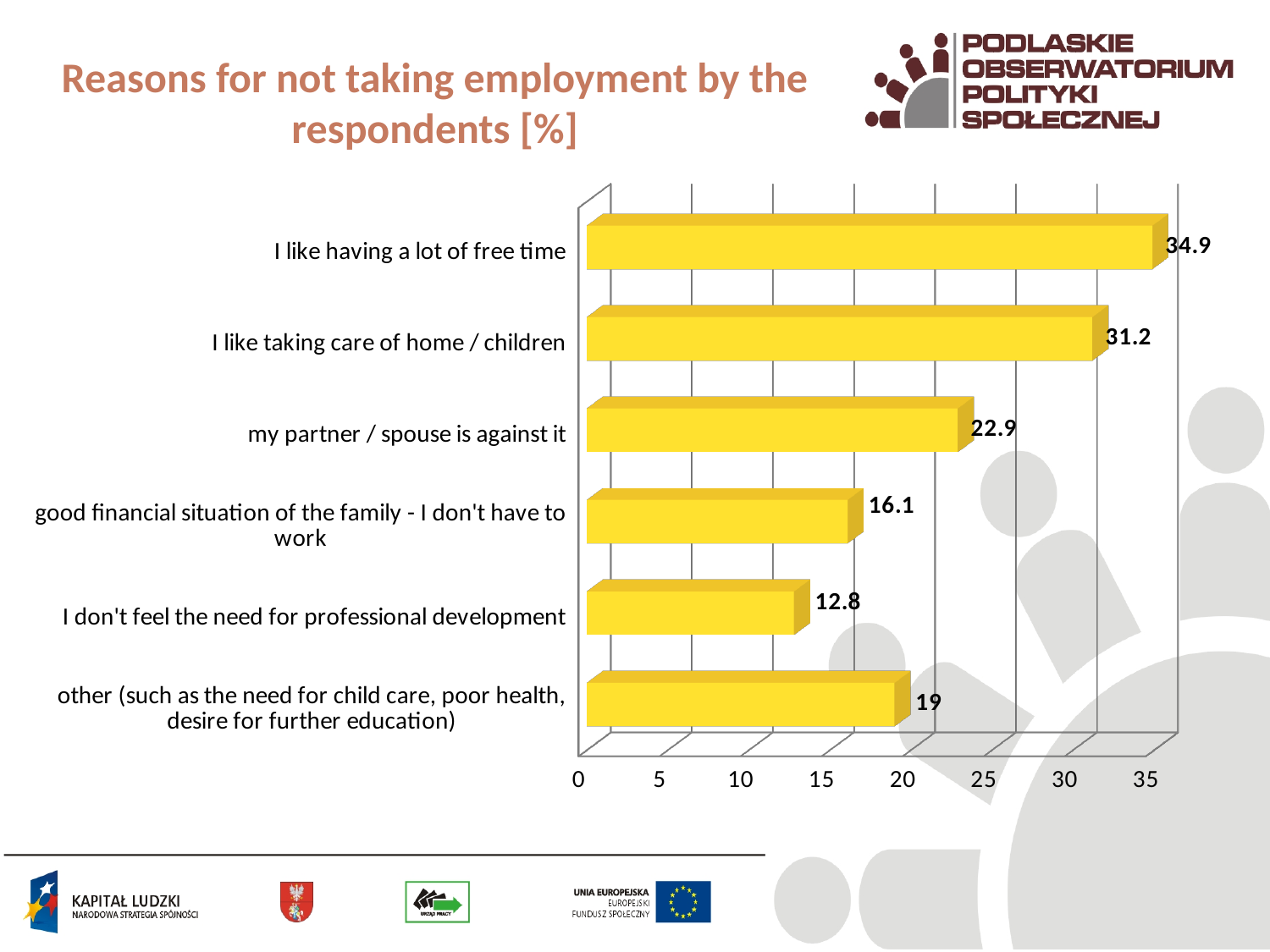
What is the title of the chart? Reasons for not taking employment by the respondents [%] Is the value for 'I like taking care of home / children' greater or less than 30? greater How many reasons are shown in the chart? 6 What is the value for 'my partner / spouse is against it'? 22.9 What is the value for 'I don't feel the need for professional development'? 12.8 Which reason has the highest value? I like having a lot of free time Which reason has the lowest value? I don't feel the need for professional development What is the value for 'I like having a lot of free time'? 34.9 What is the value for 'other (such as the need for child care, poor health, desire for further education)'? 19 Which is larger: 'good financial situation of the family - I don't have to work' or 'other (such as the need for child care, poor health, desire for further education)'? other (such as the need for child care, poor health, desire for further education) What kind of chart is shown on the slide? bar chart What is the difference between 'I like having a lot of free time' and 'I like taking care of home / children'? 3.7